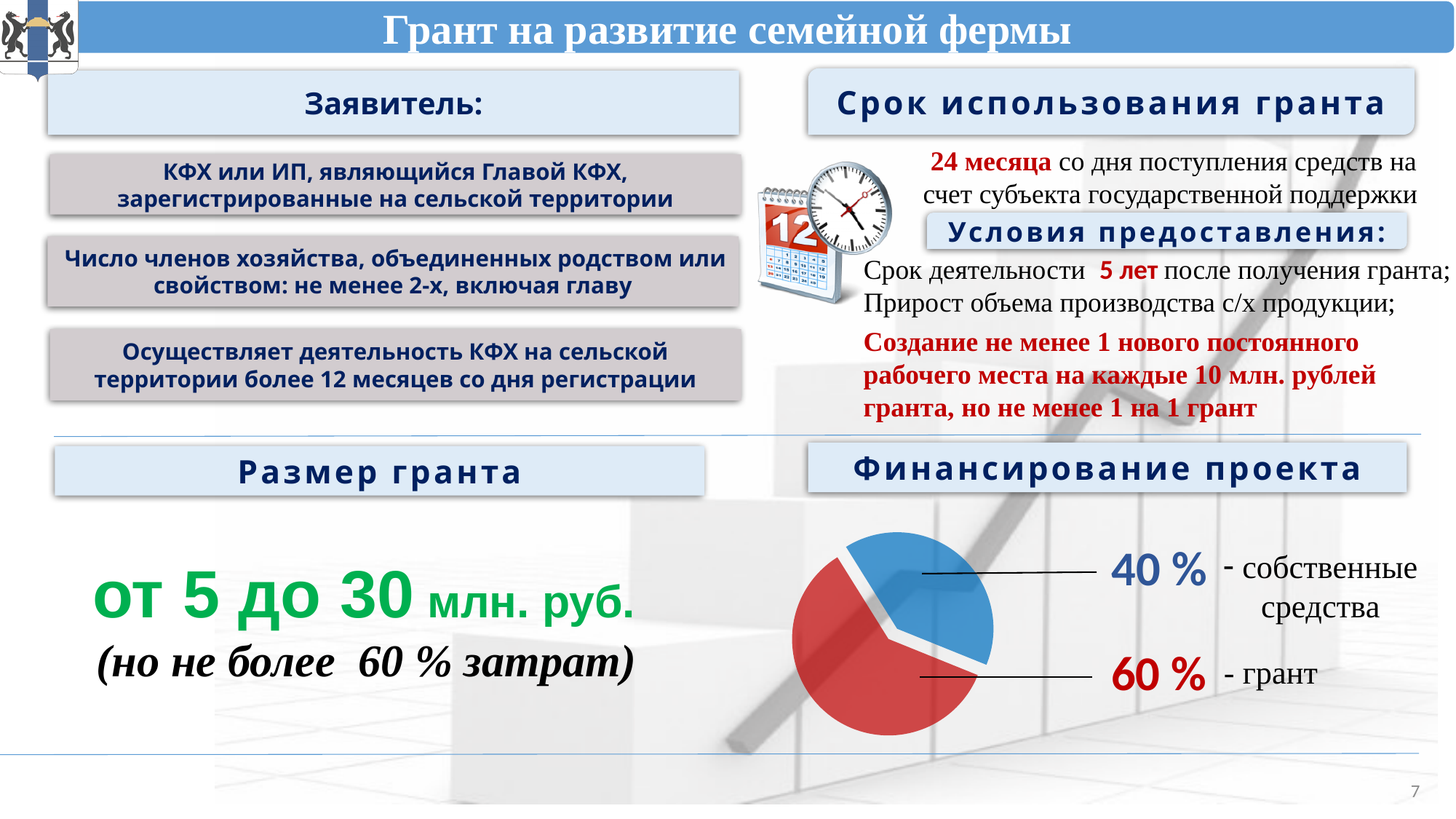
What kind of chart is shown under "Финансирование проекта"? pie chart In the pie chart under "Финансирование проекта", what share is labelled "грант"? 60 % In the pie chart under "Финансирование проекта", which slice is the largest? грант In the pie chart under "Финансирование проекта", what share is labelled "собственные средства"? 40 % In the pie chart under "Финансирование проекта", what colour is the грант slice? red In the pie chart under "Финансирование проекта", what is the total of the two slices? 100 % In the pie chart under "Финансирование проекта", which is larger: грант or собственные средства? грант In the pie chart under "Финансирование проекта", what is the difference between the грант share and the собственные средства share? 20 % In the pie chart under "Финансирование проекта", what colour is the собственные средства slice? blue In the pie chart under "Финансирование проекта", which slice is the smallest? собственные средства How many slices does the pie chart under "Финансирование проекта" have? 2